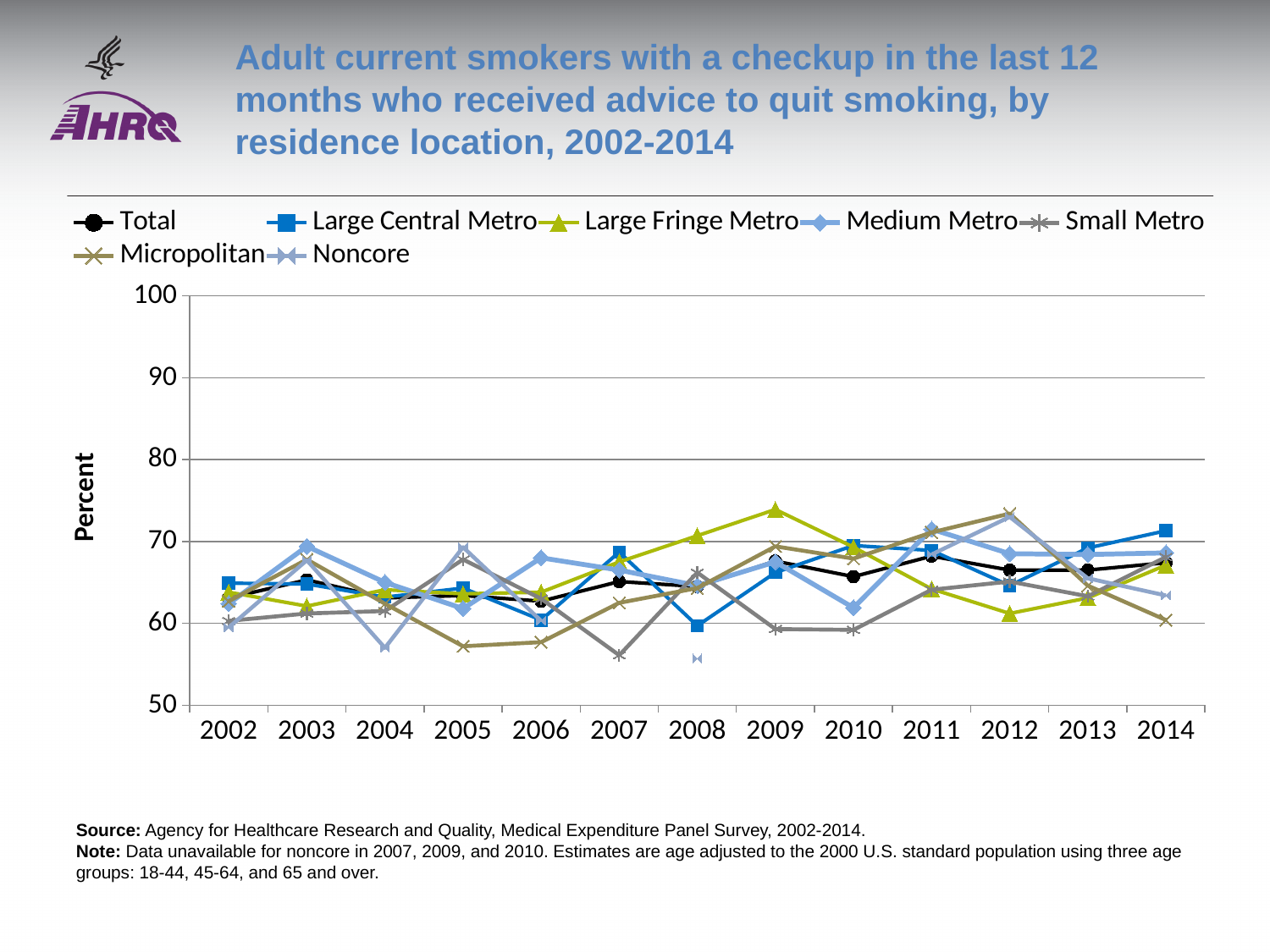
Is the value for Medium Metro in 2004 greater or less than 60? greater How many series does the legend list? 7 Is the value for Large Central Metro in 2014 greater or less than 70? greater Which series has the highest value in 2009? Large Fringe Metro What kind of chart is shown on the slide? Line chart Is the value for Large Fringe Metro in 2009 greater or less than 70? greater Which series has the lowest value in 2007? Small Metro What is the label on the y axis? Percent Does the Large Fringe Metro line rise or fall from 2006 to 2009? Rise In 2009, which is larger: the value for Large Fringe Metro or the value for Large Central Metro? Large Fringe Metro How many years are shown along the x axis? 13